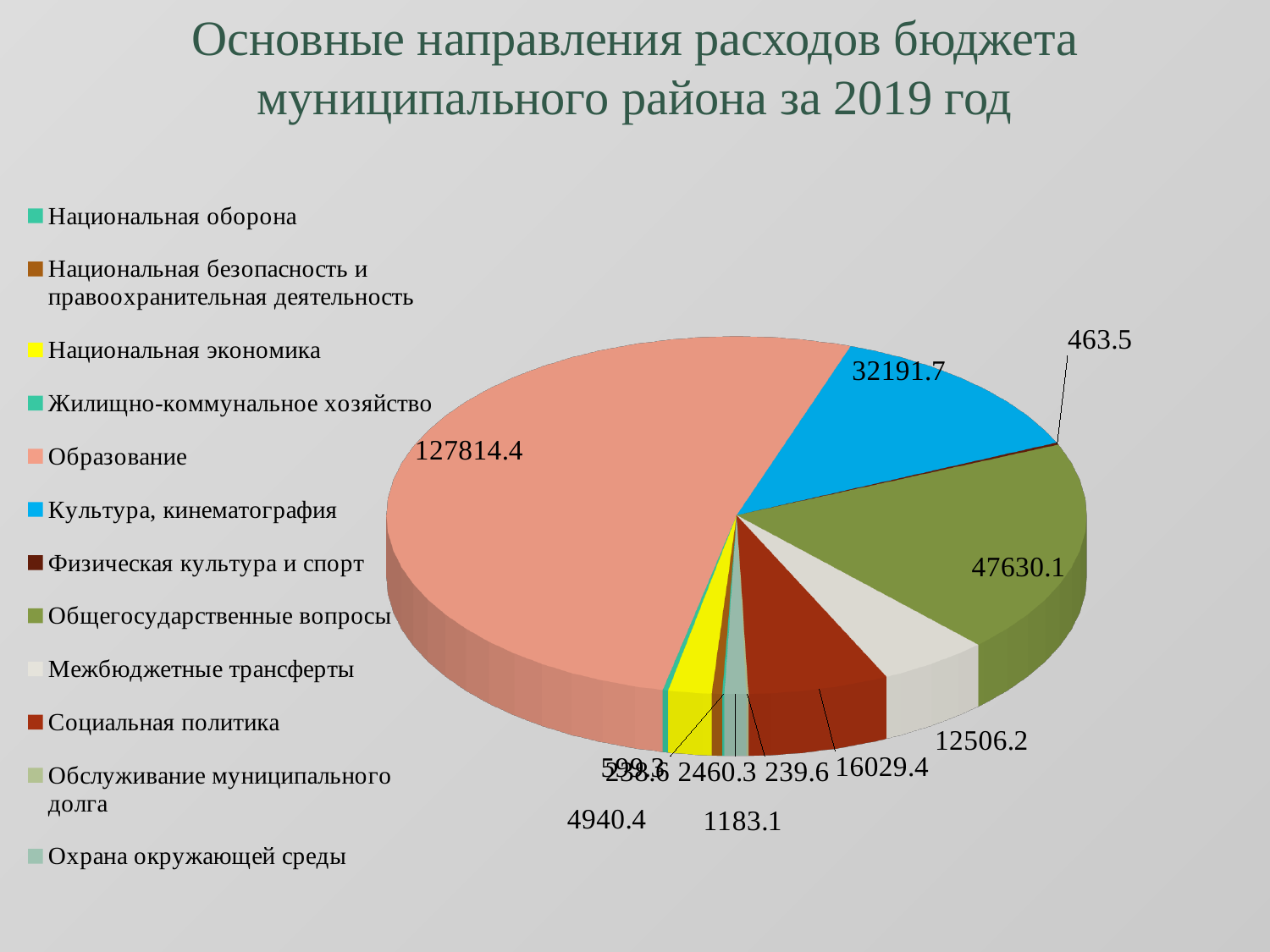
Which is larger, Общегосударственные вопросы or Культура, кинематография? Общегосударственные вопросы What is the value for Социальная политика? 16029.4 What is the value for Межбюджетные трансферты? 12506.2 What is the title of the chart on the slide? Основные направления расходов бюджета муниципального района за 2019 год What is the value for Культура, кинематография? 32191.7 What is the difference between Образование and Общегосударственные вопросы? 80184.3 What is the difference between Социальная политика and Межбюджетные трансферты? 3523.2 What type of chart is shown on the slide? pie chart Which category has the largest slice of the pie? Образование What is the value for Образование? 127814.4 How many categories does the legend list? 12 What is the value for Общегосударственные вопросы? 47630.1